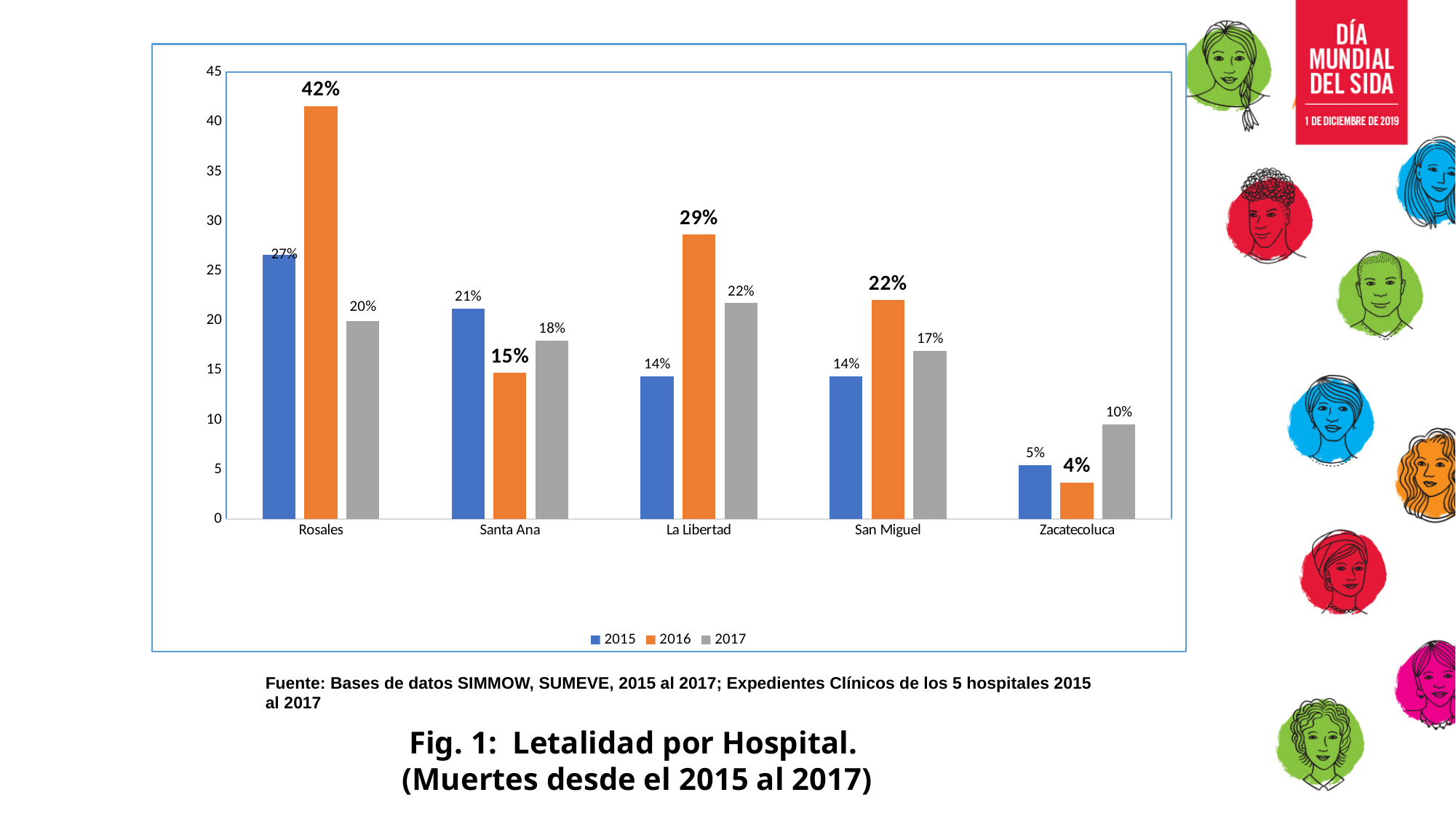
Which colour represents the 2016 series in the legend? orange What is the difference between the 2016 and 2015 values for La Libertad? 15% Which hospital has the highest value in 2016? Rosales How many series does the legend list? 3 What kind of chart is shown? bar chart What is the value for Santa Ana in 2015? 21% How many hospitals are shown on the x axis? 5 What is the value for Zacatecoluca in 2017? 10% Is the value for San Miguel in 2016 greater or less than 20? greater What is the value for Rosales in 2016? 42% Which hospital has the lowest value in 2015? Zacatecoluca Which is larger for Santa Ana: the 2015 value or the 2017 value? 2015